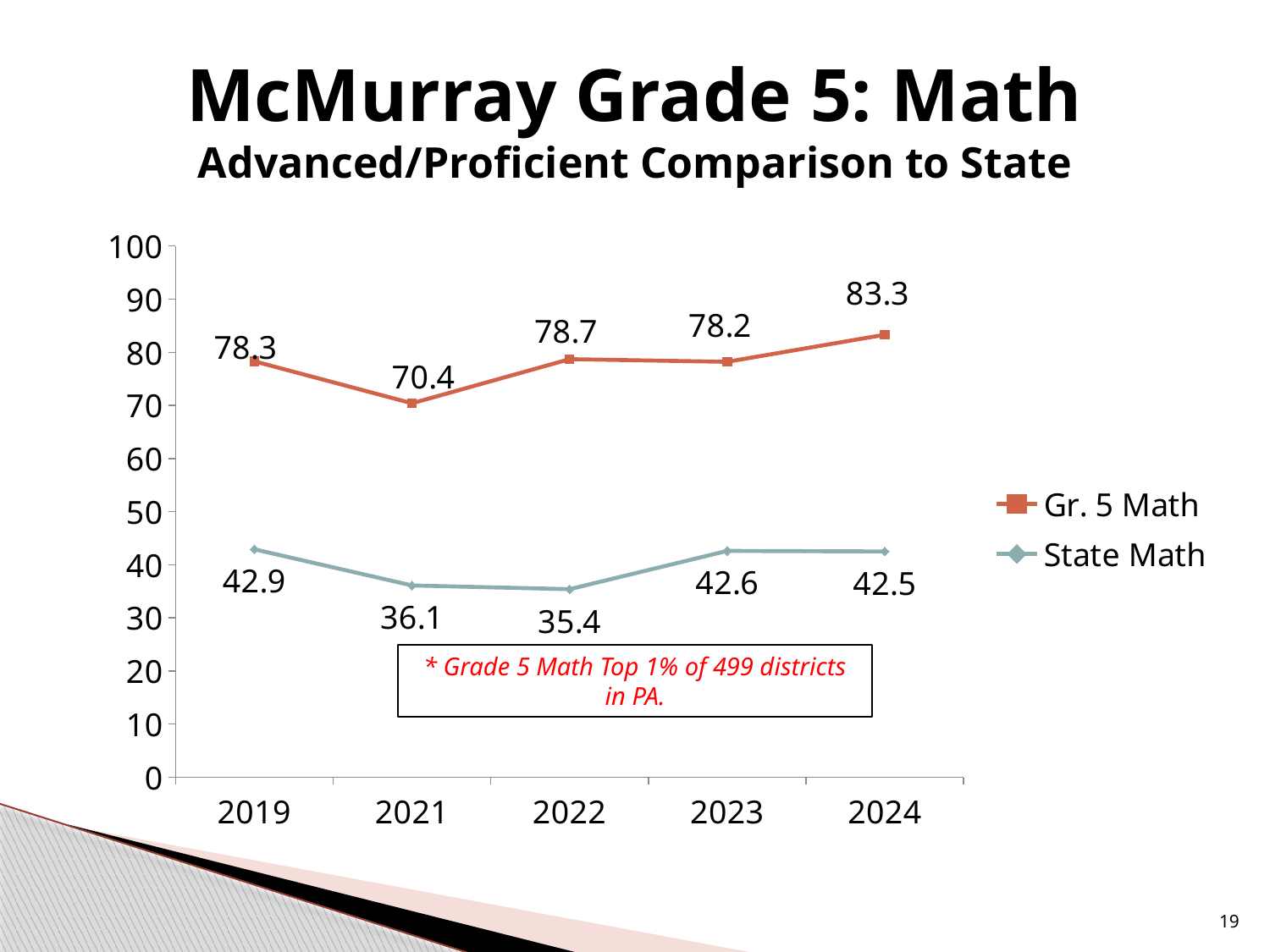
What is the Gr. 5 Math value for 2024? 83.3 In which year is the Gr. 5 Math value highest? 2024 Is the State Math value for 2023 greater or less than 40? greater What is the Gr. 5 Math value for 2021? 70.4 What kind of chart is shown on the slide? line chart How many years are shown on the x axis? 5 Does the Gr. 5 Math value rise or fall from 2023 to 2024? rise What is the difference between Gr. 5 Math and State Math in 2024? 40.8 What is the State Math value for 2022? 35.4 Which is larger in 2019, Gr. 5 Math or State Math? Gr. 5 Math How many series does the legend list? 2 In which year is the State Math value lowest? 2022